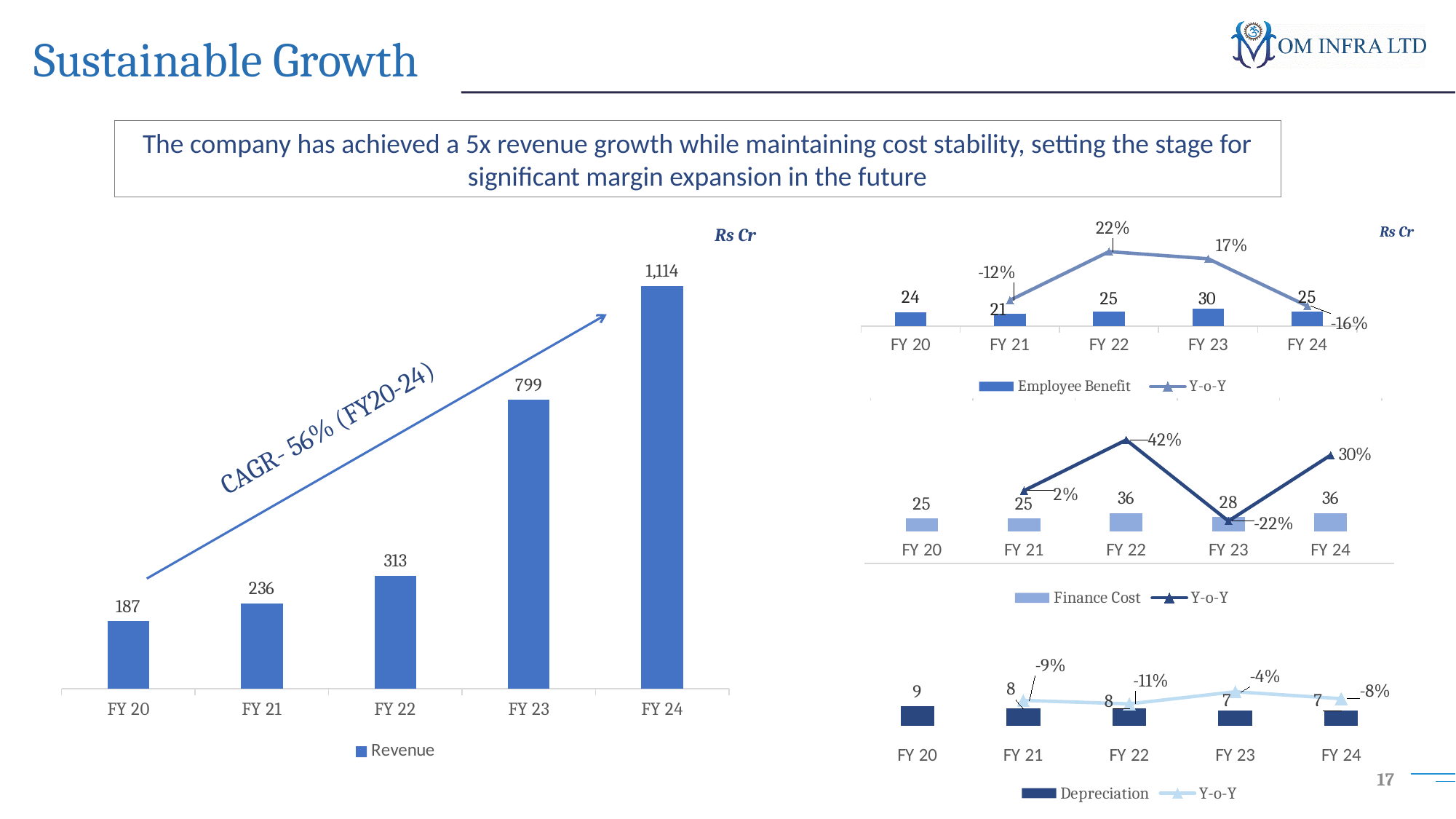
In the Revenue chart on the left, do the values rise or fall from FY 20 to FY 24? rise In the Revenue chart on the left, what is the revenue for FY 24? 1,114 In the Revenue chart on the left, what is the revenue for FY 20? 187 In the Employee Benefit chart at the top right, what is the Y-o-Y value for FY 22? 22% In the Employee Benefit chart at the top right, what is the Employee Benefit value for FY 23? 30 In the Depreciation chart at the bottom right, which fiscal year has the highest Depreciation value? FY 20 In the Revenue chart on the left, how many fiscal years are shown on the x axis? 5 In the Revenue chart on the left, what is the difference between the FY 23 and FY 22 revenue values? 486 In the Depreciation chart at the bottom right, how many series does the legend list? 2 In the Finance Cost chart in the middle right, what is the Y-o-Y value for FY 23? -22% In the Finance Cost chart in the middle right, which is larger, the Finance Cost for FY 22 or FY 23? FY 22 In the Employee Benefit chart at the top right, which fiscal year has the lowest Employee Benefit value? FY 21